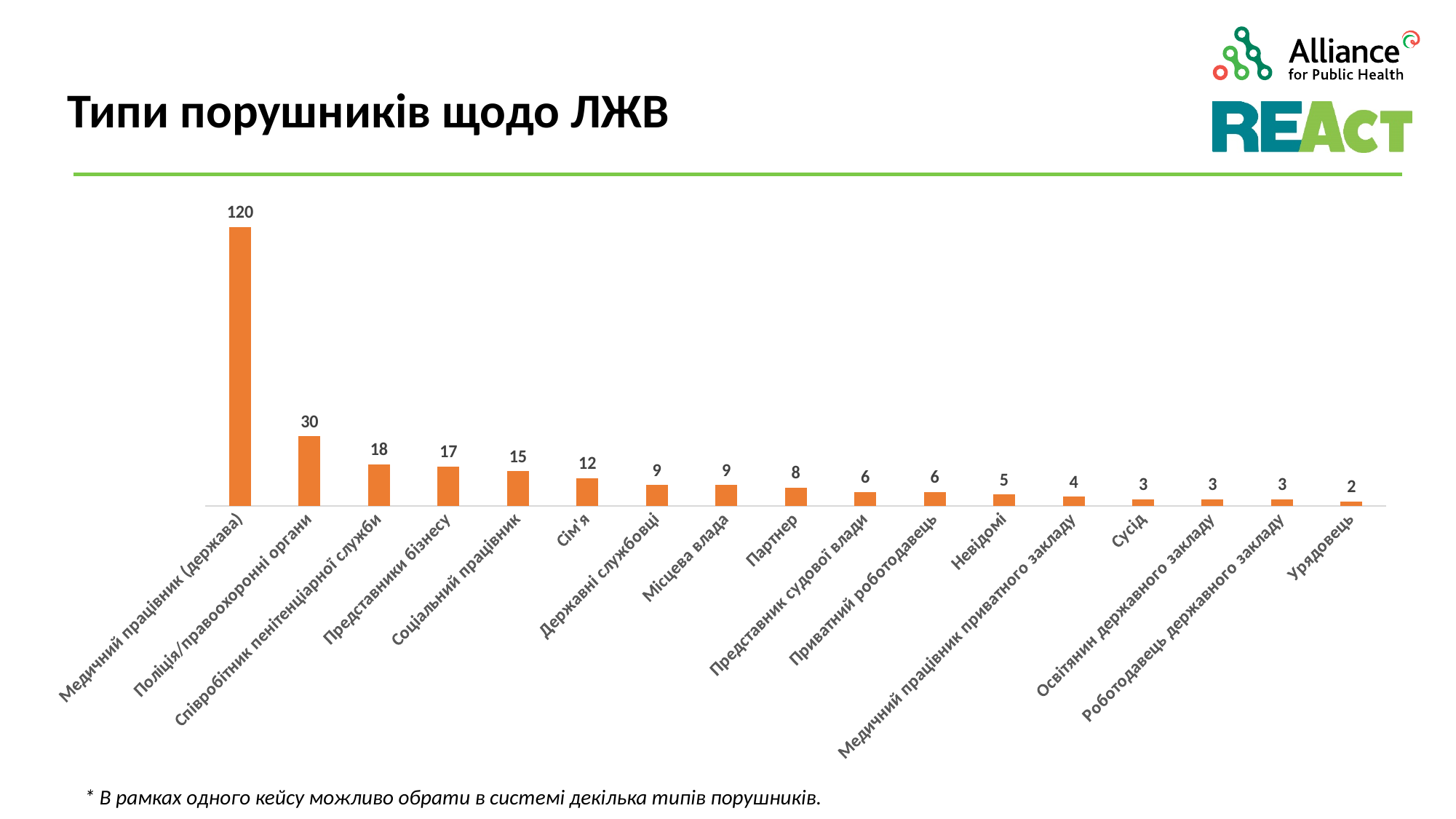
How many categories are shown in the chart? 17 What is the value for Поліція/правоохоронні органи? 30 What is the title of the chart? Типи порушників щодо ЛЖВ What is the value for Медичний працівник (держава)? 120 Which category has the lowest value? Урядовець Which category has the highest value? Медичний працівник (держава) What kind of chart is shown on the slide? Bar chart Do the values rise or fall from left to right along the x axis? Fall Which is larger, the value for Представники бізнесу or the value for Співробітник пенітенціарної служби? Співробітник пенітенціарної служби What is the value for Соціальний працівник? 15 What is the value for Сім'я? 12 What is the difference between the values for Медичний працівник (держава) and Поліція/правоохоронні органи? 90